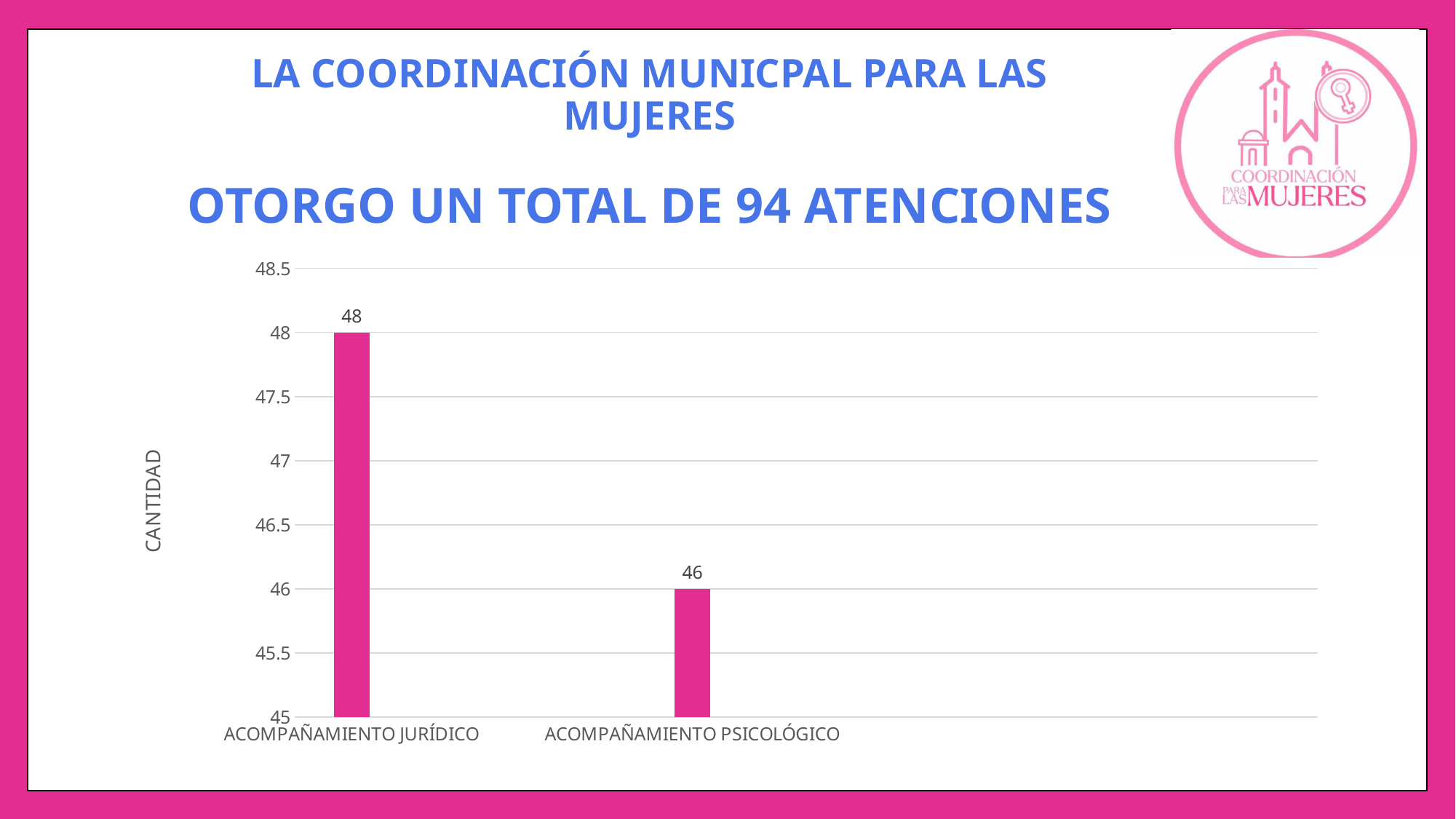
What kind of chart is shown on the slide? bar chart Which is larger, the value for ACOMPAÑAMIENTO JURÍDICO or ACOMPAÑAMIENTO PSICOLÓGICO? ACOMPAÑAMIENTO JURÍDICO Is the value for ACOMPAÑAMIENTO PSICOLÓGICO greater or less than 47? less Which category has the lowest value? ACOMPAÑAMIENTO PSICOLÓGICO Which category has the highest value? ACOMPAÑAMIENTO JURÍDICO What is the difference between the values for ACOMPAÑAMIENTO JURÍDICO and ACOMPAÑAMIENTO PSICOLÓGICO? 2 What is the value for ACOMPAÑAMIENTO JURÍDICO? 48 How many categories are shown in the chart? 2 Is the value for ACOMPAÑAMIENTO JURÍDICO greater or less than 47? greater What is the value for ACOMPAÑAMIENTO PSICOLÓGICO? 46 What is the label of the vertical axis? CANTIDAD What colour are the bars in the chart? pink